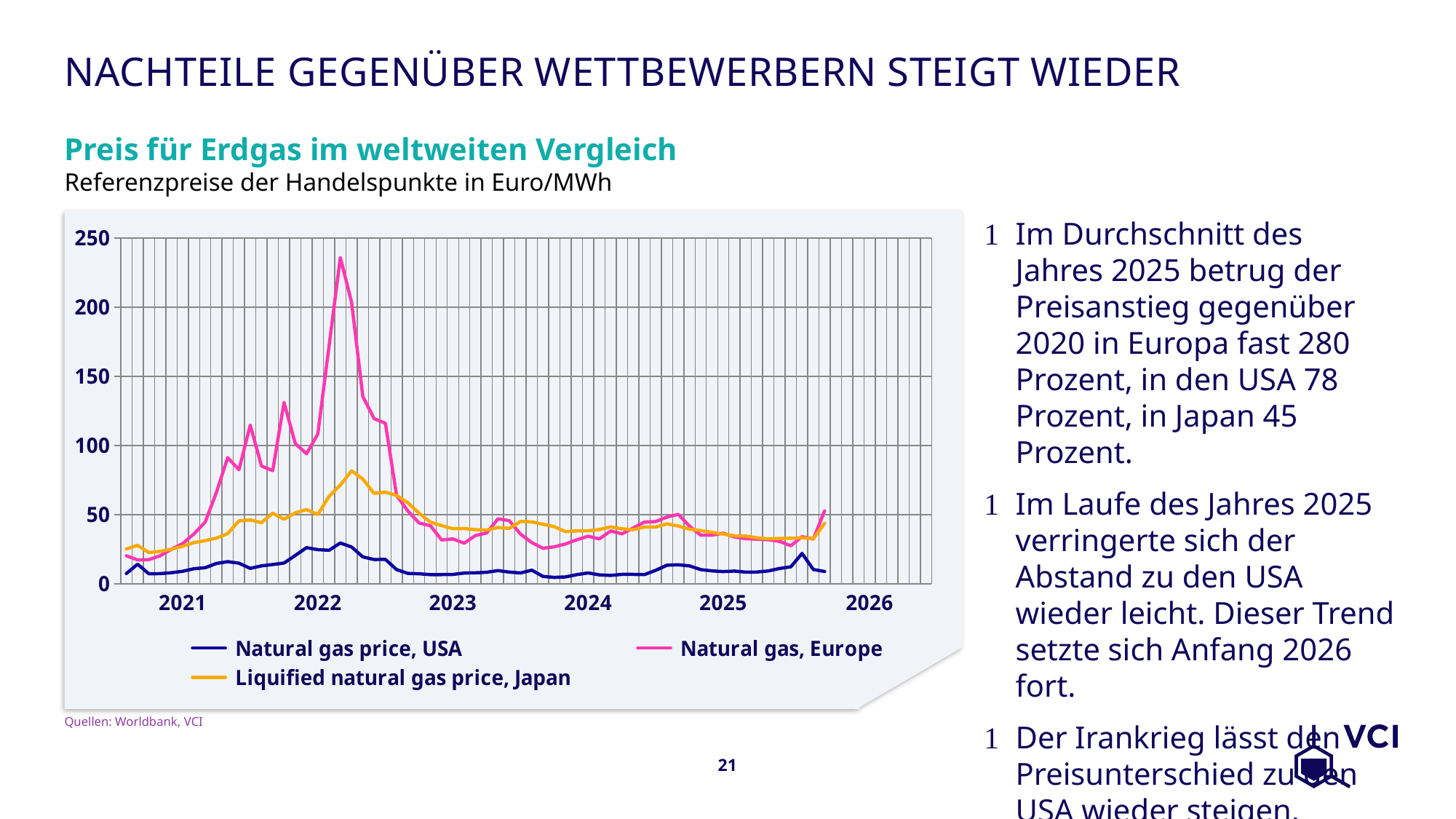
What kind of chart is shown on the slide? line chart Does the Natural gas, Europe series rise or fall from its 2022 peak to 2023? fall Is the peak value for Liquified natural gas price, Japan greater or less than 100? less What is the title of the chart? Preis für Erdgas im weltweiten Vergleich Is the highest value for Natural gas price, USA greater or less than 50? less Is the peak value for Natural gas, Europe greater or less than 200? greater Which series is drawn in pink? Natural gas, Europe Which series stays lowest across the whole period shown? Natural gas price, USA How many series does the chart legend list? 3 Which series reaches the highest value on the chart? Natural gas, Europe Which is larger at its peak in 2022: Natural gas, Europe or Liquified natural gas price, Japan? Natural gas, Europe In what unit are the prices on the chart given? Euro/MWh